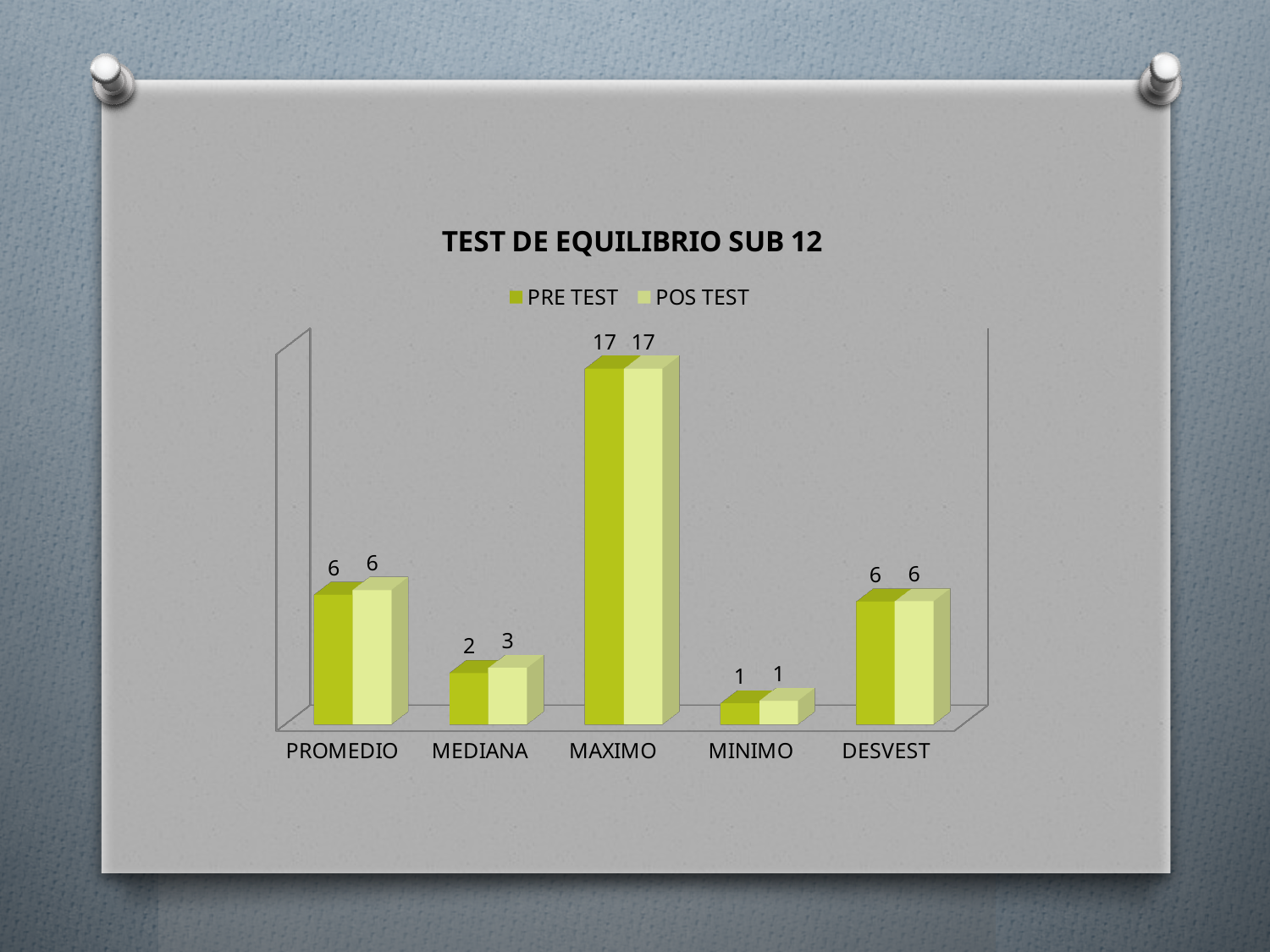
Which category has the lowest POS TEST value? MINIMO How many categories are shown on the x axis? 5 What is the difference between the POS TEST and PRE TEST values for MEDIANA? 1 What is the PRE TEST value for DESVEST? 6 What is the difference between the PRE TEST values for MAXIMO and PROMEDIO? 11 What is the POS TEST value for MINIMO? 1 Which is larger for MEDIANA, the PRE TEST value or the POS TEST value? POS TEST What is the POS TEST value for MEDIANA? 3 How many series does the legend list? 2 What is the PRE TEST value for MAXIMO? 17 Which category has the highest PRE TEST value? MAXIMO What kind of chart is shown on the slide? Bar chart